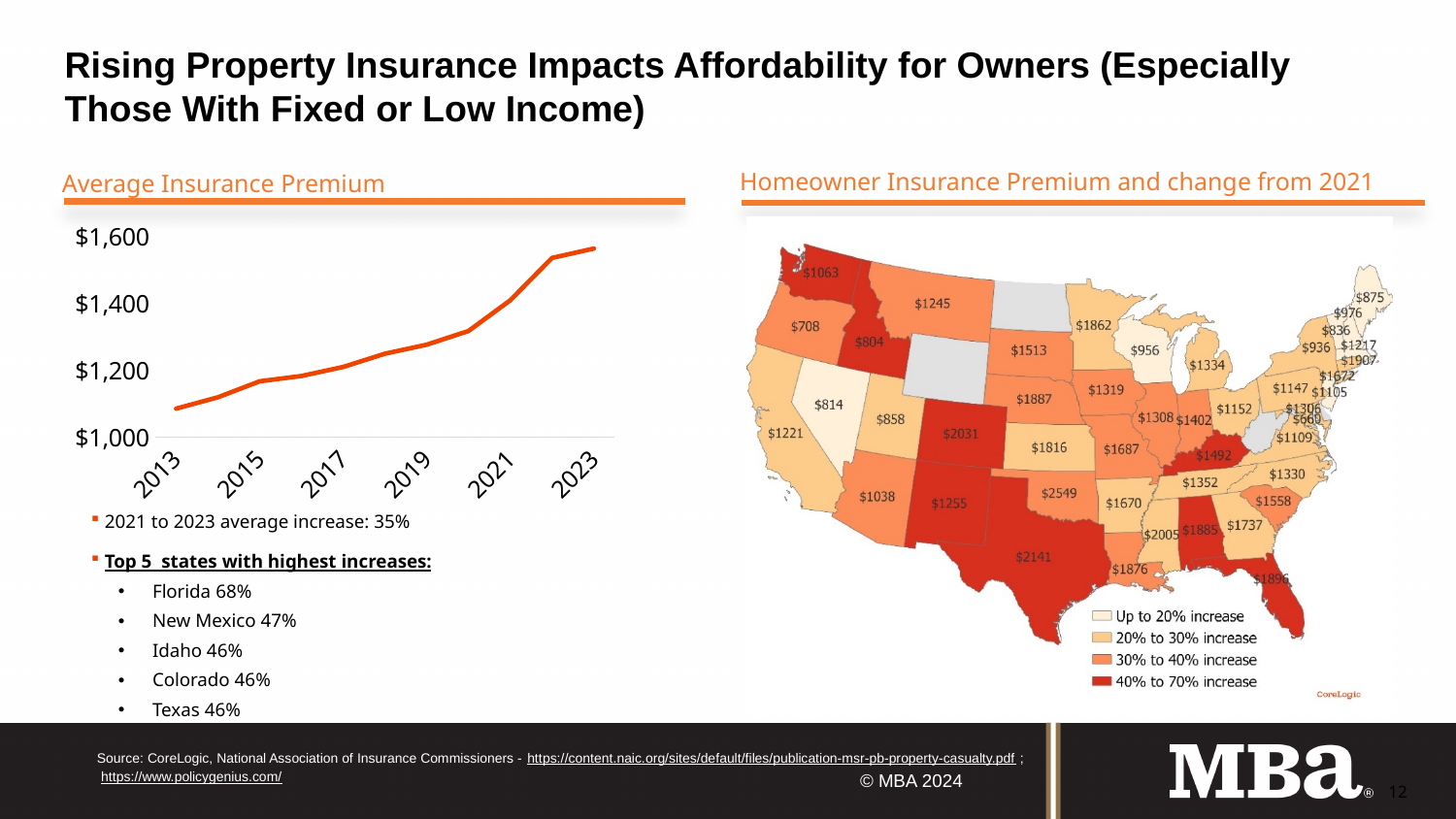
In the Average Insurance Premium chart, which is larger, the value for 2015 or the value for 2021? 2021 In the Average Insurance Premium chart, is the value for 2013 greater or less than $1,200? less In the Average Insurance Premium chart, is the value for 2019 greater or less than $1,400? less In the Average Insurance Premium chart, is the value for 2023 greater or less than $1,400? greater In the Average Insurance Premium chart, which year has the lowest value? 2013 How many year labels are shown on the x axis of the Average Insurance Premium chart? 6 In the Average Insurance Premium chart, which year has the highest value? 2023 In the Average Insurance Premium chart, do the values rise or fall from 2013 to 2023? rise What is the title of the line chart on the left of the slide? Average Insurance Premium How many increase ranges does the legend of the Homeowner Insurance Premium map list? 4 What kind of chart is the Average Insurance Premium chart? line chart